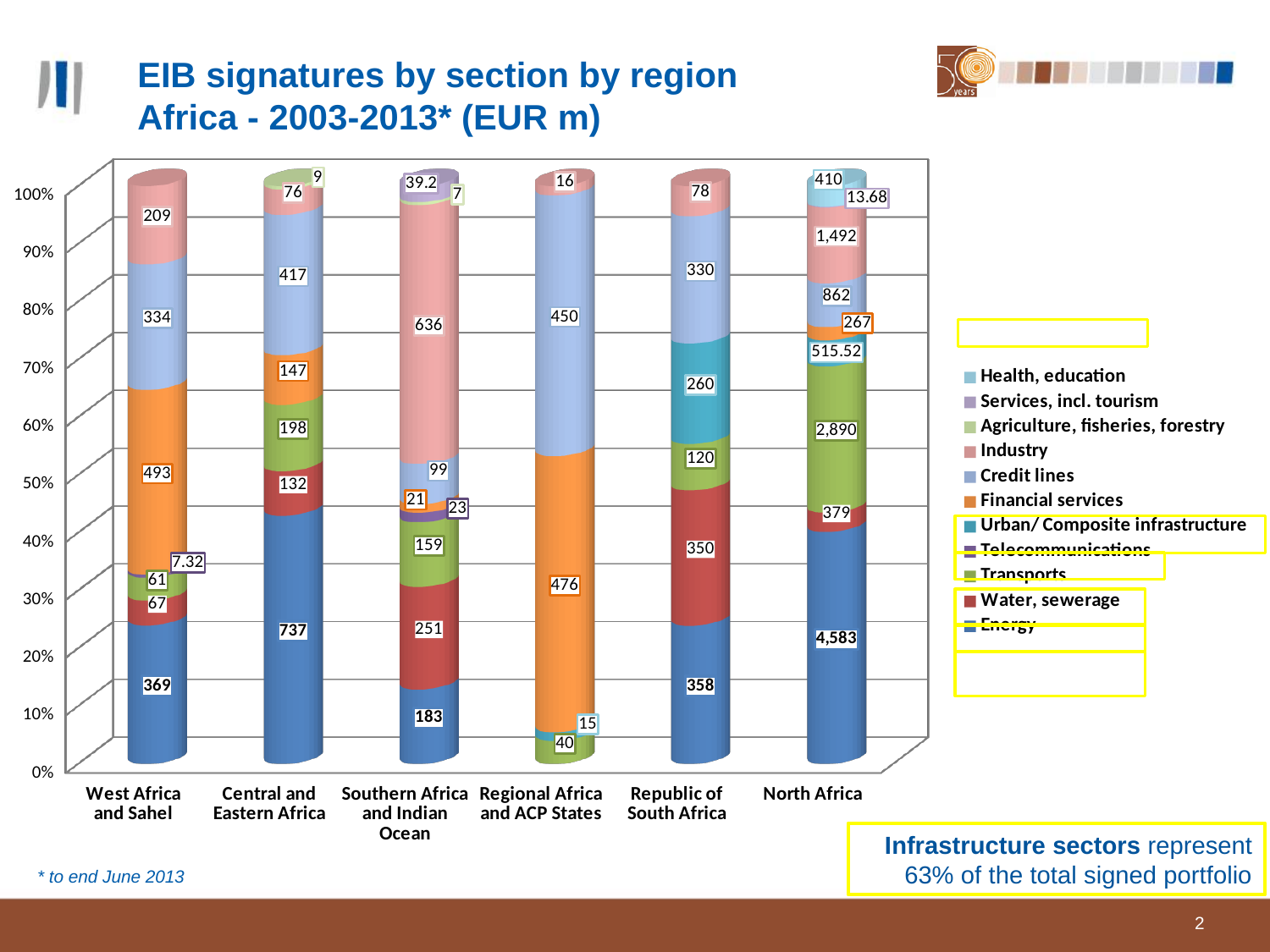
What kind of chart is shown on the slide? Stacked bar chart How many regions are shown on the x axis? 6 What is the value for Financial services in Regional Africa and ACP States? 476 What is the value for Energy in North Africa? 4,583 What is the title of the chart? EIB signatures by section by region Africa - 2003-2013* (EUR m) What is the value for Urban/ Composite infrastructure in Republic of South Africa? 260 What is the value for Transports in North Africa? 2,890 What is the difference between the Credit lines values for Central and Eastern Africa and West Africa and Sahel? 83 Which is larger, the Water, sewerage value for Republic of South Africa or for Central and Eastern Africa? Republic of South Africa How many series does the legend list? 11 Which region has the highest Energy value? North Africa What is the value for Industry in Southern Africa and Indian Ocean? 636